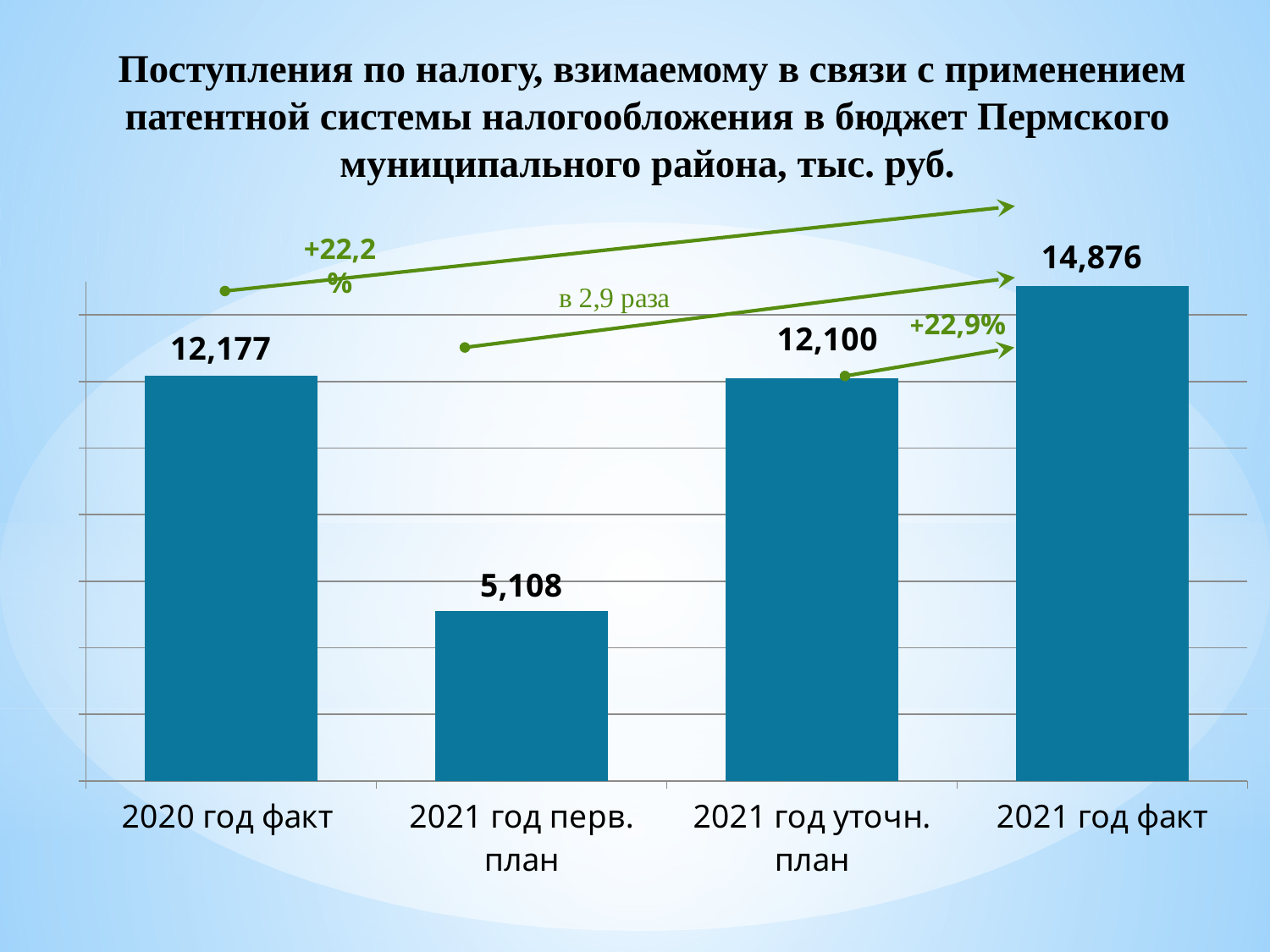
Which category has the highest value? 2021 год факт What is the value for "2021 год перв. план"? 5,108 What is the value for "2021 год уточн. план"? 12,100 Which is larger: the value for "2020 год факт" or the value for "2021 год перв. план"? 2020 год факт Which category has the lowest value? 2021 год перв. план What type of chart is shown on the slide? Bar chart What is the difference between the values for "2021 год факт" and "2020 год факт"? 2,699 What is the difference between the values for "2020 год факт" and "2021 год перв. план"? 7,069 What percentage change is annotated between "2021 год уточн. план" and "2021 год факт"? +22,9% What is the value for "2021 год факт"? 14,876 What is the value for "2020 год факт"? 12,177 How many categories are shown on the x axis? 4